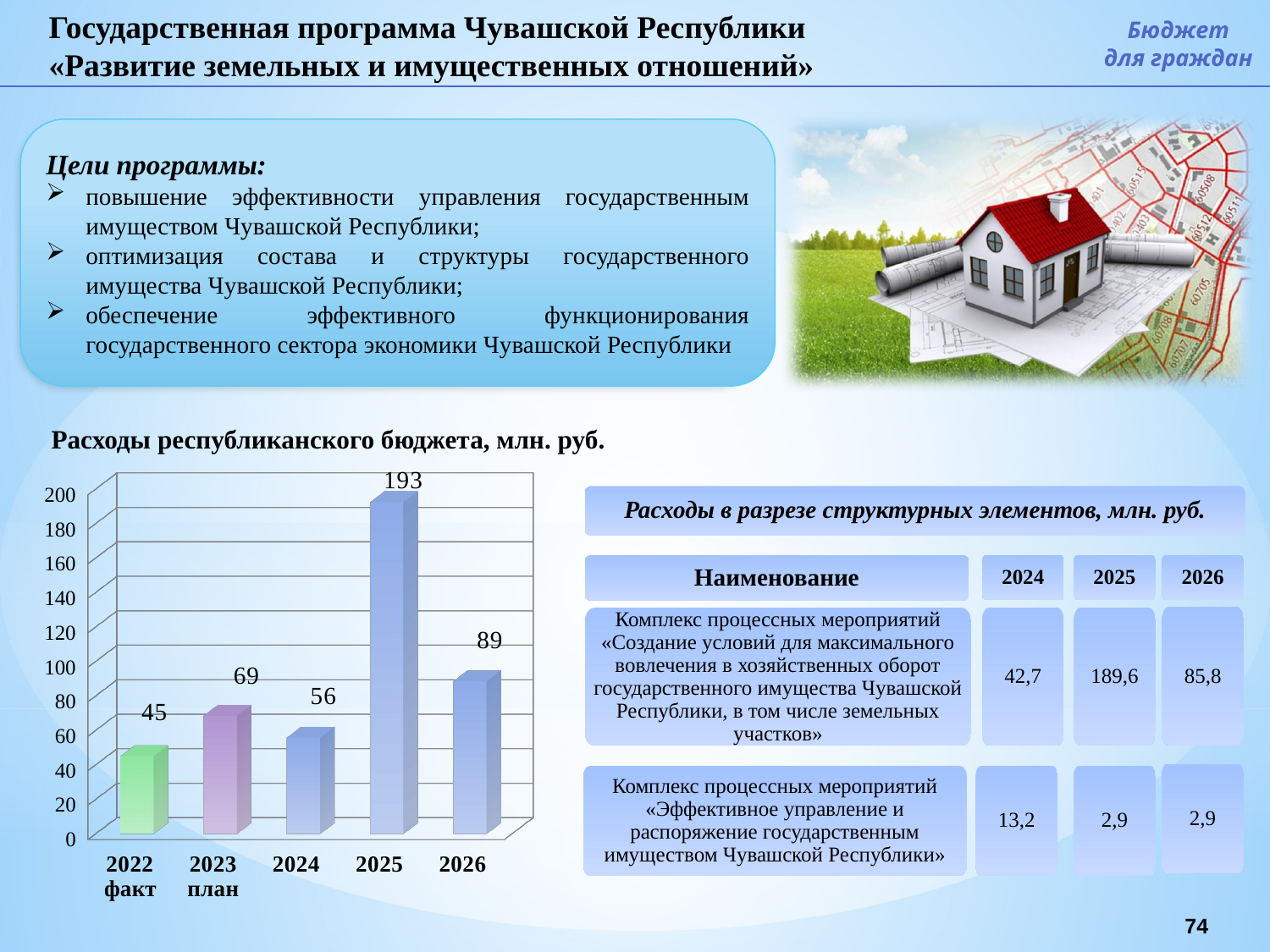
What kind of chart is shown on the slide? bar chart What is the difference between the values for 2023 план and 2024 in the chart? 13 Is the value for 2026 in the chart greater or less than 100? less What is the value for 2025 in the chart "Расходы республиканского бюджета, млн. руб."? 193 Which year has the lowest value in the chart? 2022 факт What is the value for 2024 in the chart? 56 Which year has the highest value in the chart? 2025 How many years (categories) are shown in the chart? 5 What is the difference between the values for 2025 and 2026 in the chart? 104 Which is larger in the chart, the value for 2023 план or the value for 2026? 2026 What is the title of the chart on the slide? Расходы республиканского бюджета, млн. руб. What is the value for 2022 факт in the chart? 45